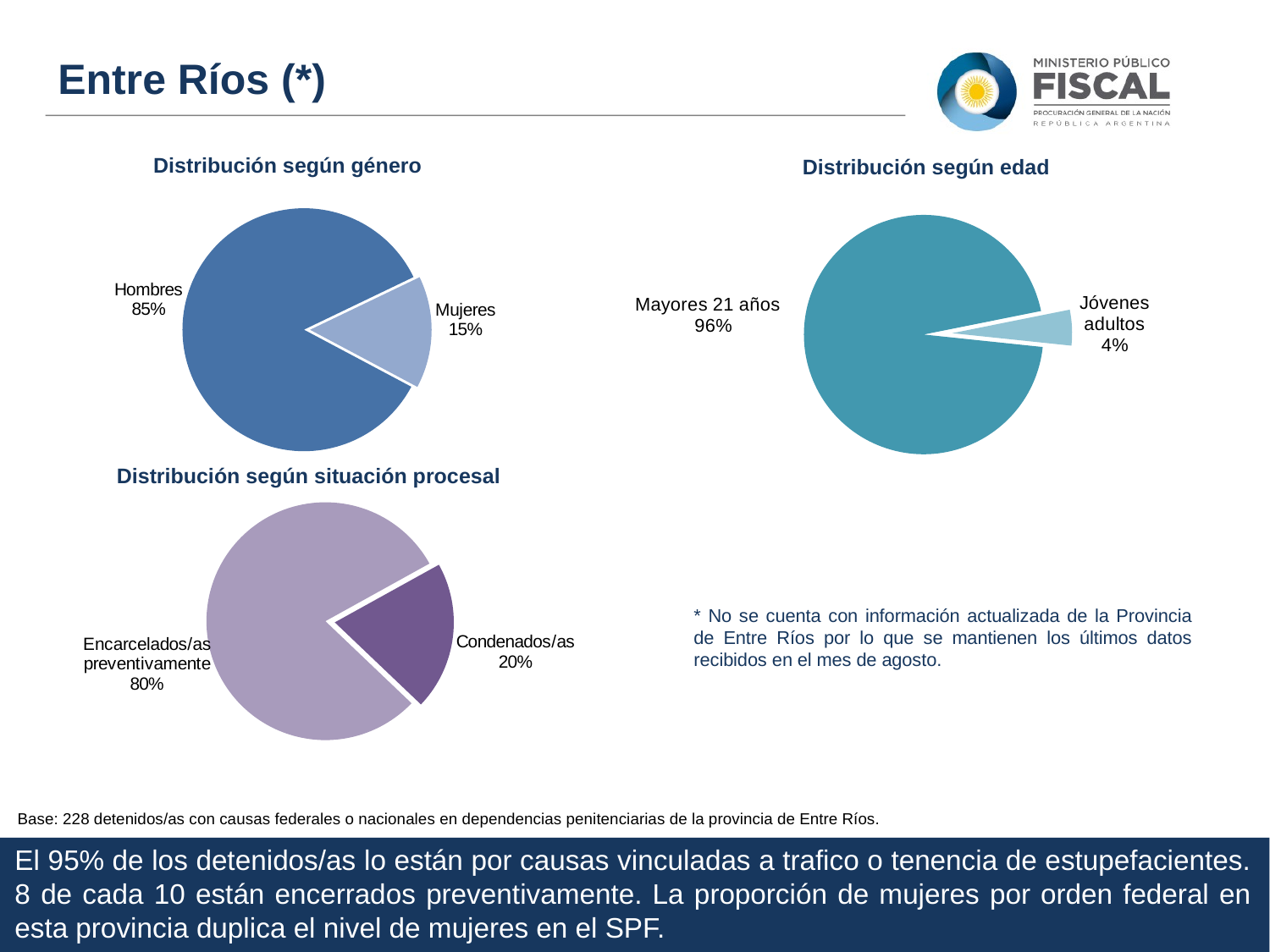
What type of chart is 'Distribución según situación procesal'? Pie chart In the 'Distribución según situación procesal' chart, what is the difference in percentage points between Encarcelados/as preventivamente and Condenados/as? 60 How many slices does the 'Distribución según edad' chart have? 2 In the 'Distribución según género' chart, what share is labelled for Mujeres? 15% In the 'Distribución según género' chart, what share is labelled for Hombres? 85% In the 'Distribución según edad' chart, what share is labelled for Mayores 21 años? 96% In the 'Distribución según situación procesal' chart, what share is labelled for Condenados/as? 20% In the 'Distribución según situación procesal' chart, which category has the largest slice? Encarcelados/as preventivamente In the 'Distribución según género' chart, which category has the smallest slice? Mujeres In the 'Distribución según edad' chart, what share is labelled for Jóvenes adultos? 4% In the 'Distribución según género' chart, what is the difference in percentage points between Hombres and Mujeres? 70 In the 'Distribución según edad' chart, which is larger, Mayores 21 años or Jóvenes adultos? Mayores 21 años